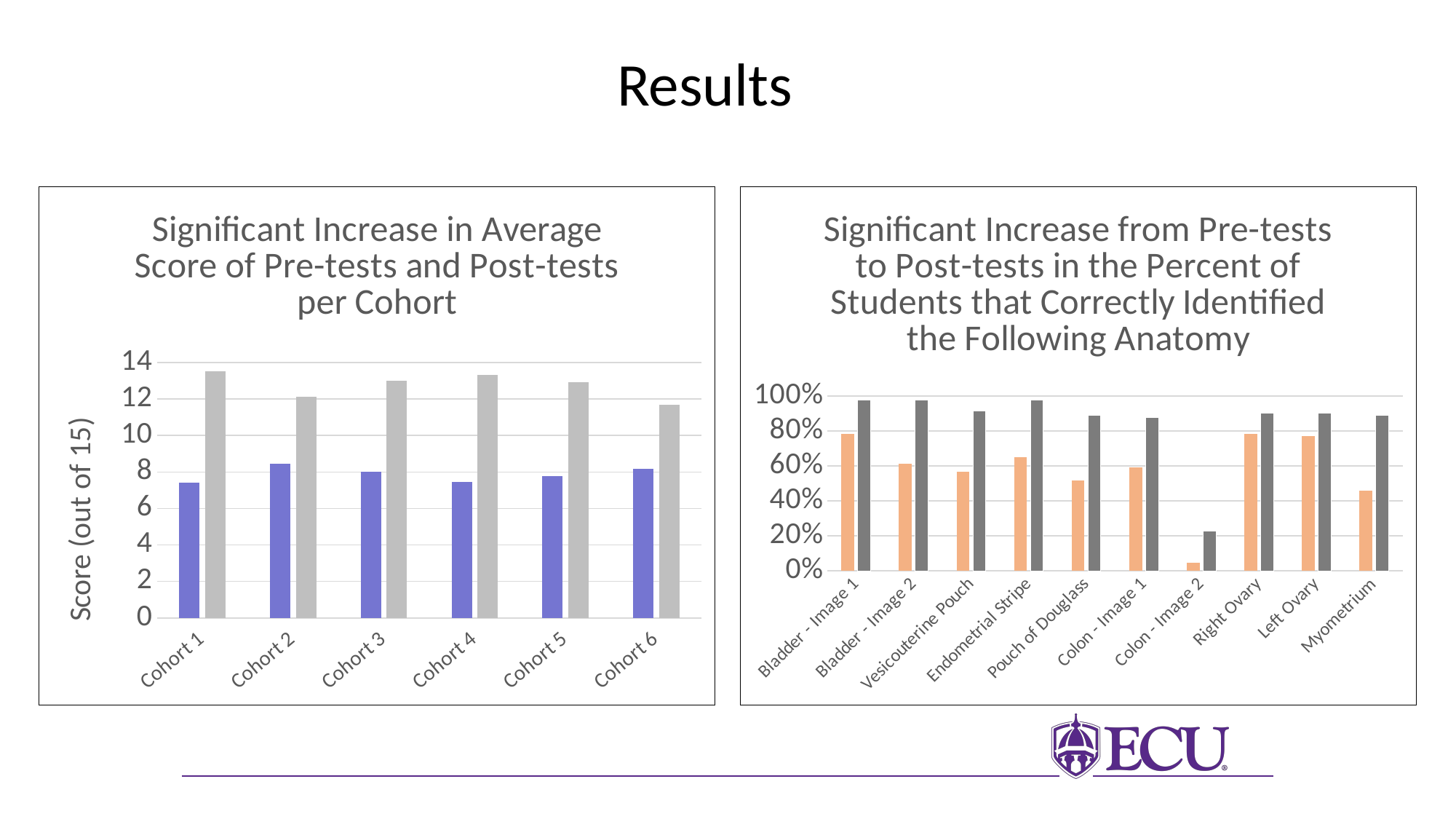
In the right chart, which is larger: the orange bar for Bladder - Image 1 or the orange bar for Pouch of Douglass? Bladder - Image 1 In the left chart, how many cohorts are shown on the x axis? 6 In the left chart, is the gray bar for Cohort 1 greater or less than 12? greater In the left chart, which cohort has the lowest gray bar? Cohort 6 In the right chart, which category has the lowest orange bar? Colon - Image 2 In the right chart, is the dark gray bar for Colon - Image 2 greater or less than 40%? less In the left chart, what is the label of the vertical axis? Score (out of 15) In the right chart, how many anatomy categories are shown on the x axis? 10 In the left chart, which is larger: the gray bar for Cohort 1 or the gray bar for Cohort 6? Cohort 1 In the right chart, is the dark gray bar for Bladder - Image 1 greater or less than 80%? greater What kind of chart is the left chart, 'Significant Increase in Average Score of Pre-tests and Post-tests per Cohort'? bar chart